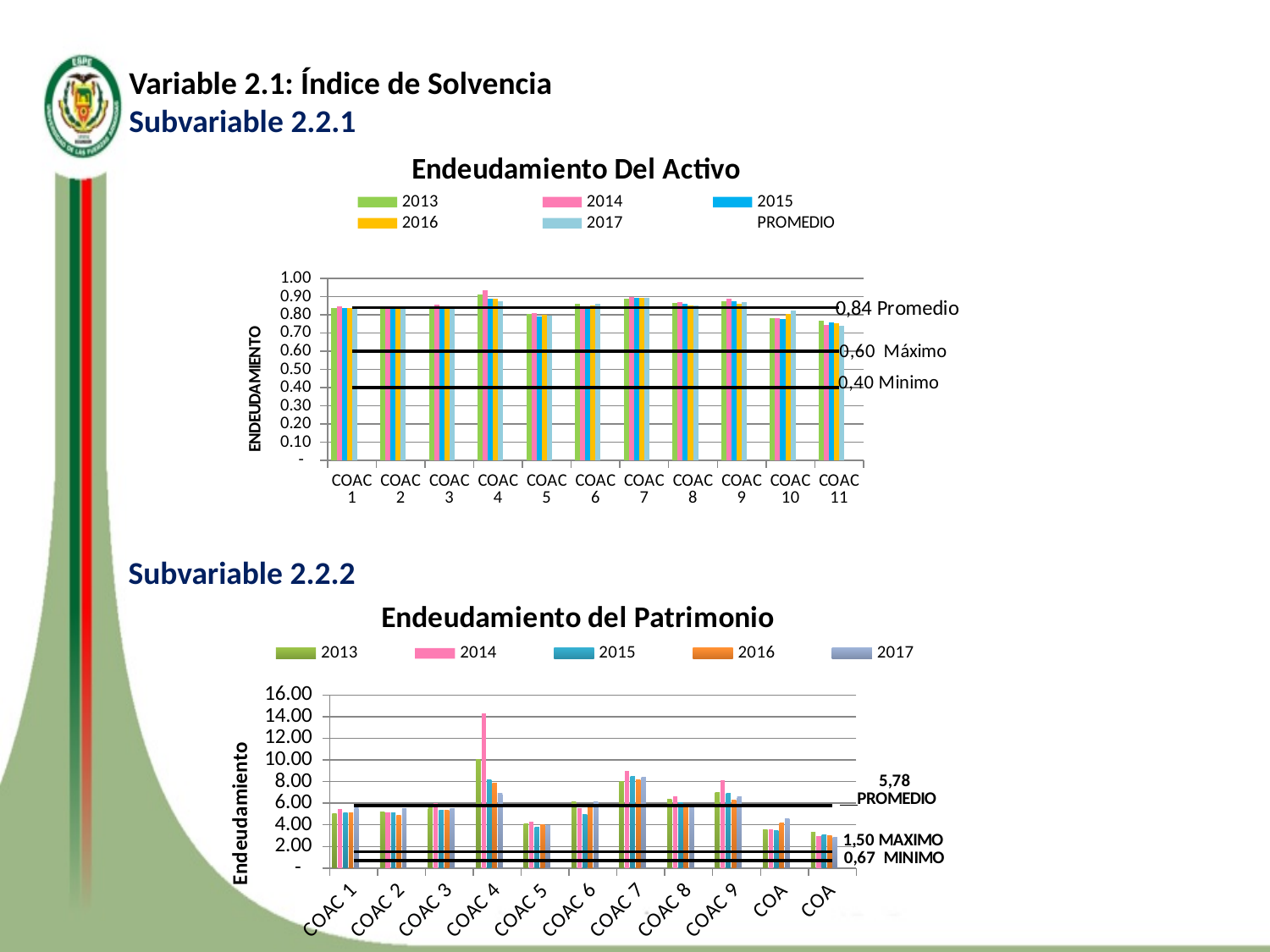
What kind of chart is the 'Endeudamiento Del Activo' chart? bar chart In the 'Endeudamiento del Patrimonio' chart, which COAC has the highest bar? COAC 4 In the 'Endeudamiento Del Activo' chart, is the 2013 value for COAC 11 greater or less than 0.80? less In the 'Endeudamiento del Patrimonio' chart, is the 2013 value for COAC 1 greater or less than 6.00? less How many COAC categories are shown on the x axis of the 'Endeudamiento Del Activo' chart? 11 In the 'Endeudamiento Del Activo' chart, which COAC has the lowest bars overall? COAC 11 In the 'Endeudamiento Del Activo' chart, what value is labelled as the Promedio reference line? 0,84 How many series does the legend of the 'Endeudamiento Del Activo' chart list? 6 In the 'Endeudamiento Del Activo' chart, what value is labelled as the Minimo reference line? 0,40 In the 'Endeudamiento del Patrimonio' chart, what value is labelled as the PROMEDIO reference line? 5,78 How many series does the legend of the 'Endeudamiento del Patrimonio' chart list? 5 In the 'Endeudamiento del Patrimonio' chart, is the 2014 value for COAC 4 greater or less than 12.00? greater